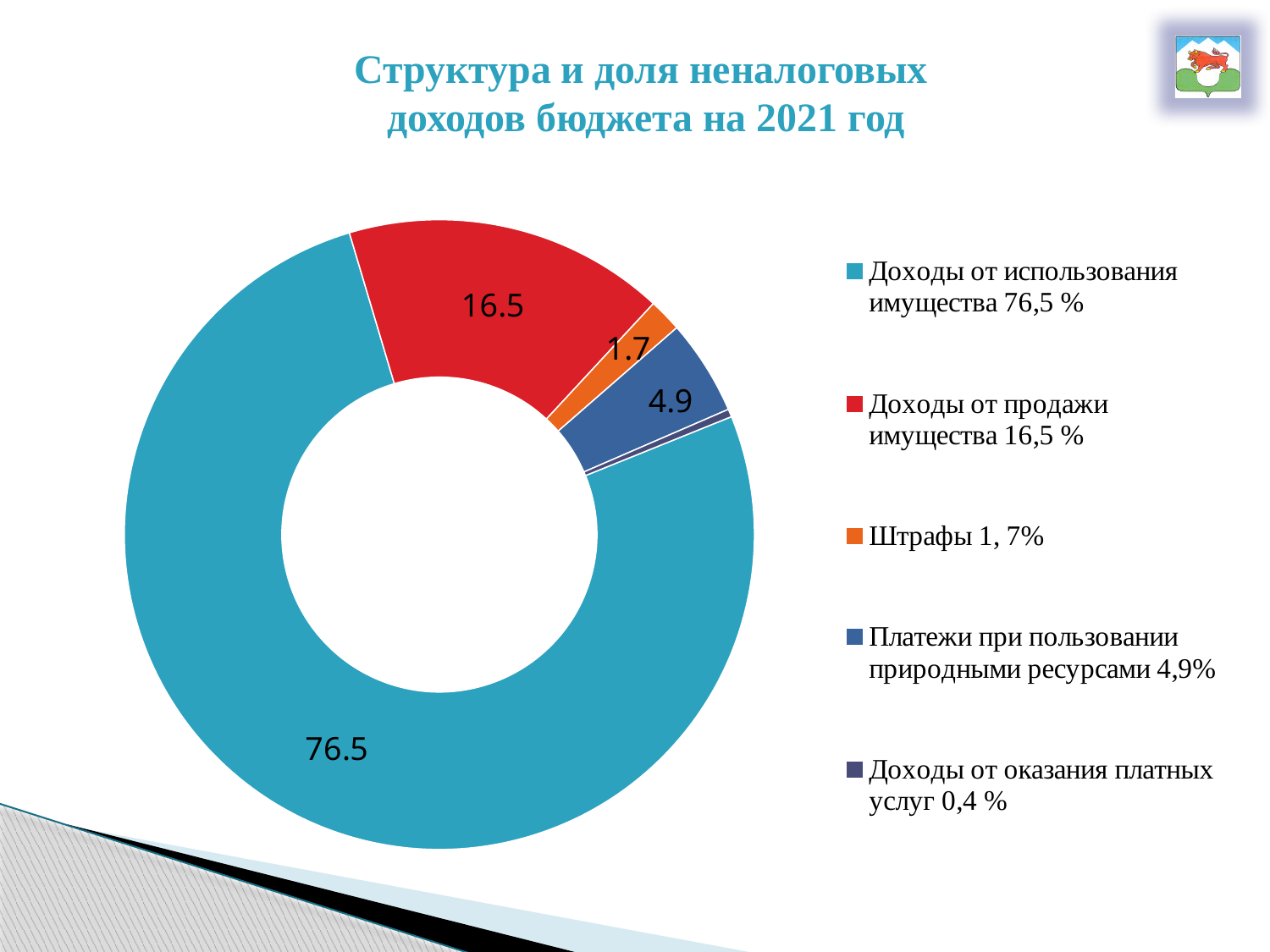
Which is larger: the slice for Штрафы or the slice for Платежи при пользовании природными ресурсами? Платежи при пользовании природными ресурсами What is the value shown for Штрафы? 1.7 Which category has the smallest slice? Доходы от оказания платных услуг What is the difference between the values for Доходы от использования имущества and Доходы от продажи имущества? 60 What is the difference between the values for Платежи при пользовании природными ресурсами and Штрафы? 3.2 How many categories does the chart show? 5 According to the legend, what share do Доходы от оказания платных услуг have? 0,4 % What is the value shown for Доходы от продажи имущества? 16.5 What kind of chart is shown on the slide? doughnut (pie) chart Which category has the largest slice? Доходы от использования имущества What is the value shown for Платежи при пользовании природными ресурсами? 4.9 What is the value shown for Доходы от использования имущества? 76.5